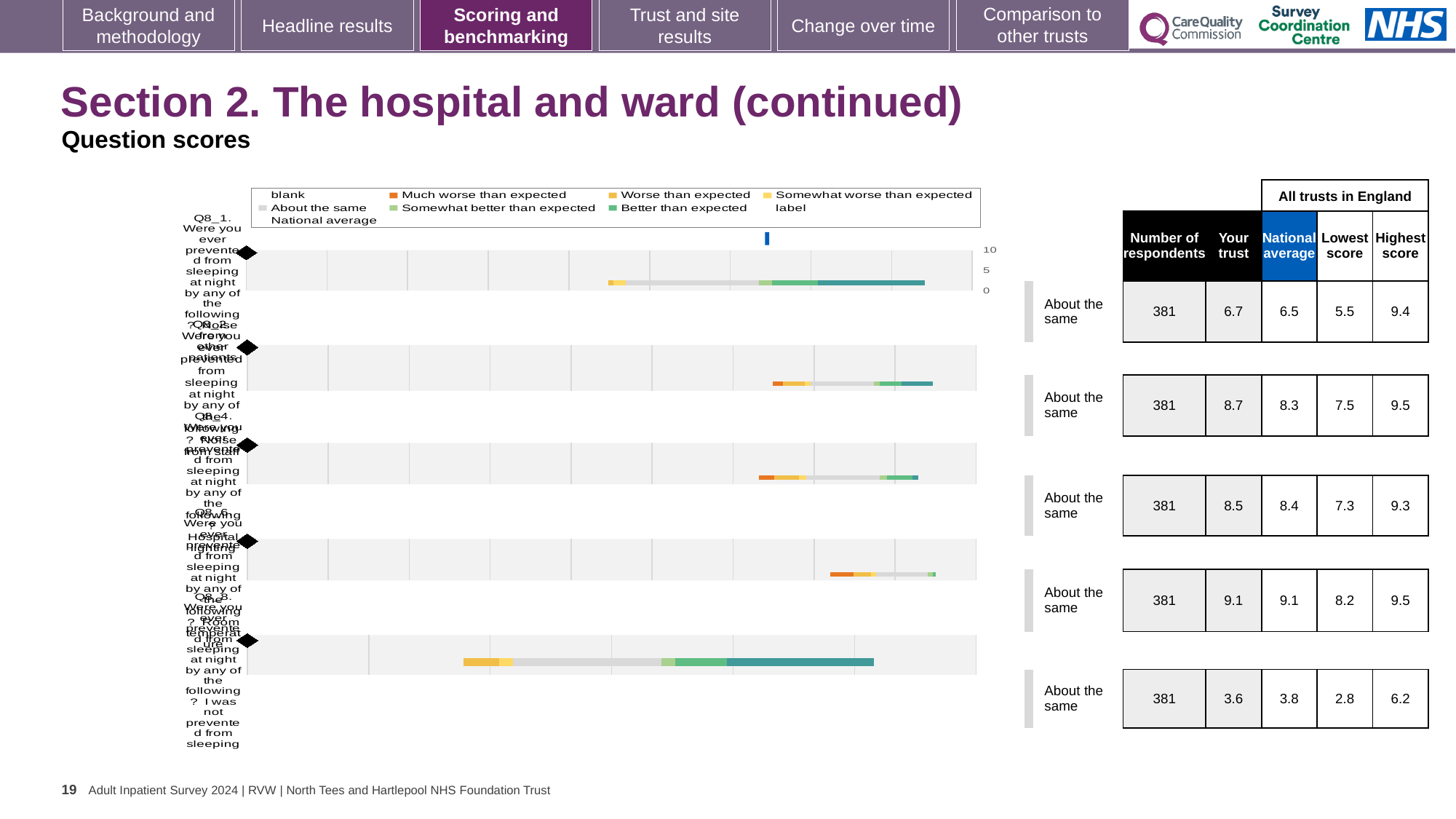
In the table beside the chart, what is the 'Your trust' score for the first row (Q8_1)? 6.7 For the first row, which is larger: the 'Your trust' score or the national average? Your trust In the table beside the chart, what is the highest score for the second row? 9.5 What kind of chart is shown on the slide? bar chart For the fourth row, what is the difference between the highest score (9.5) and the lowest score (8.2)? 1.3 How many question rows (bars) are plotted in the chart? 5 Which legend entry is shown in dark teal? Better than expected Which row has the lowest 'Your trust' score in the table beside the chart? the bottom row (3.6) In the table beside the chart, what is the national average for the first row (Q8_1)? 6.5 In the table beside the chart, what is the lowest score for the bottom row? 2.8 In the table beside the chart, what is the number of respondents for the bottom row? 381 What benchmark label is shown next to every row of the chart? About the same